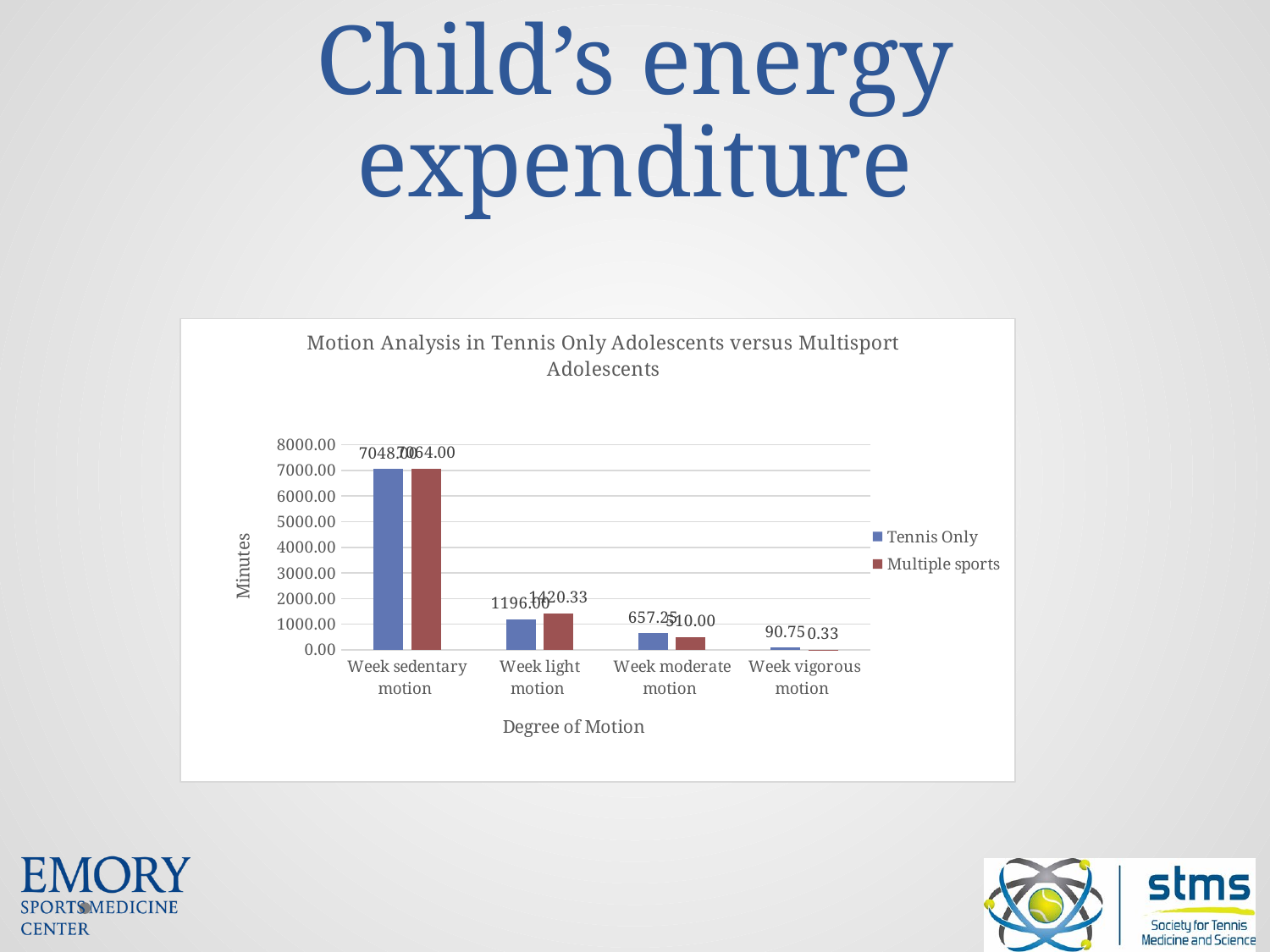
Which category has the lowest Multiple sports value? Week vigorous motion How many categories are shown on the x axis? 4 Which category has the highest Tennis Only value? Week sedentary motion What is the Tennis Only value for Week moderate motion? 657.25 What is the Tennis Only value for Week vigorous motion? 90.75 For Week moderate motion, which series has the larger value, Tennis Only or Multiple sports? Tennis Only Is the Tennis Only value for Week sedentary motion greater or less than 6000.00? greater How many series does the legend list? 2 For Week light motion, which series has the larger value, Tennis Only or Multiple sports? Multiple sports What kind of chart is shown on the slide? bar chart Do the Tennis Only values rise or fall from Week sedentary motion to Week vigorous motion? fall What is the Tennis Only value for Week light motion? 1196.00